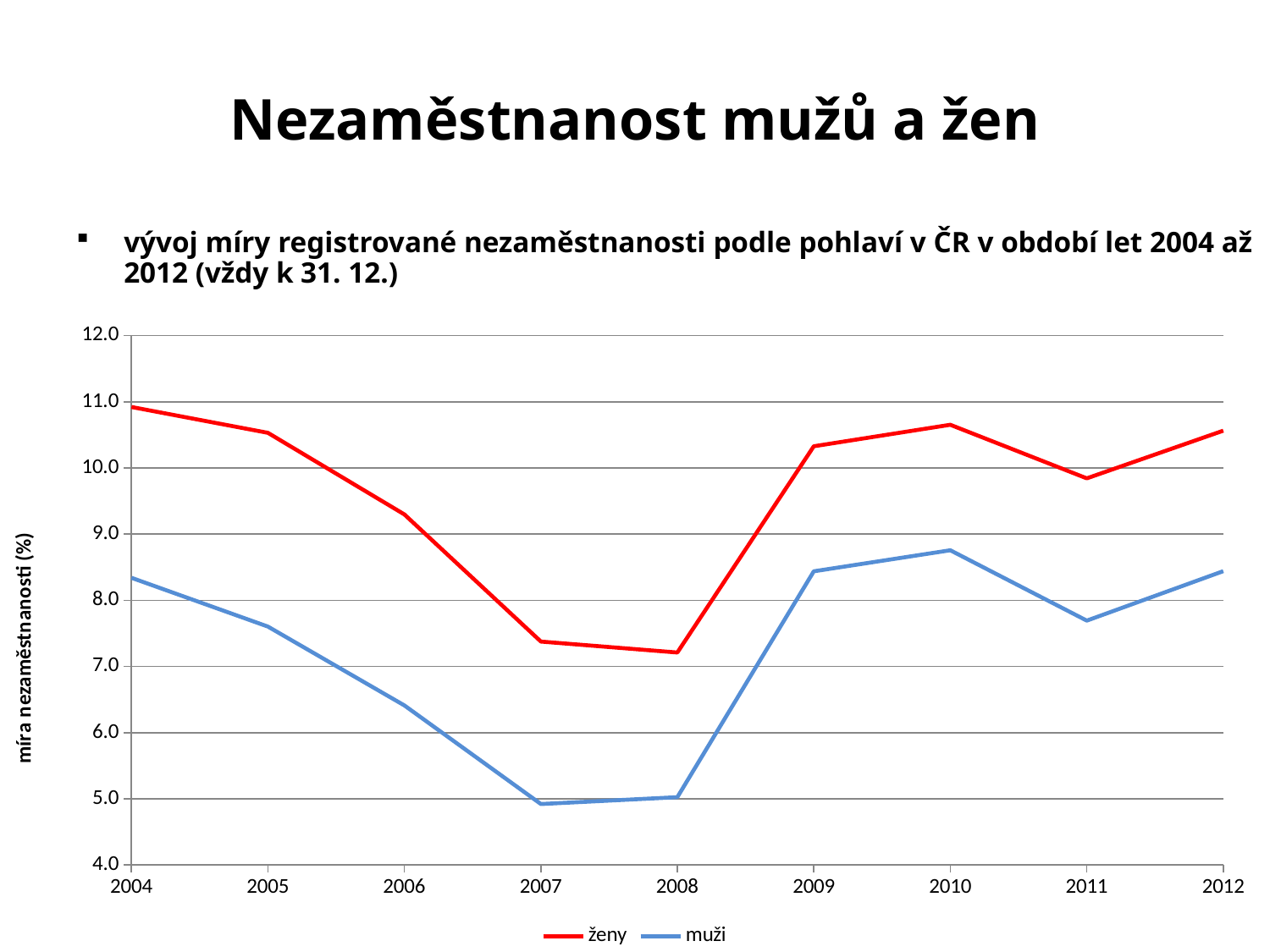
Do the values for ženy rise or fall from 2004 to 2008? fall Is the value for muži in 2006 greater or less than 7.0? less In which year is the value for ženy highest? 2004 In which year is the value for muži highest? 2010 What kind of chart is shown on the slide? line chart Which series is drawn in red? ženy Is the value for ženy in 2004 greater or less than 10.0? greater How many series does the legend list? 2 Is the value for ženy in 2008 greater or less than 8.0? less What is the label of the vertical axis? míra nezaměstnanosti (%) Which series has the larger value in 2007, ženy or muži? ženy How many years are plotted along the x axis? 9